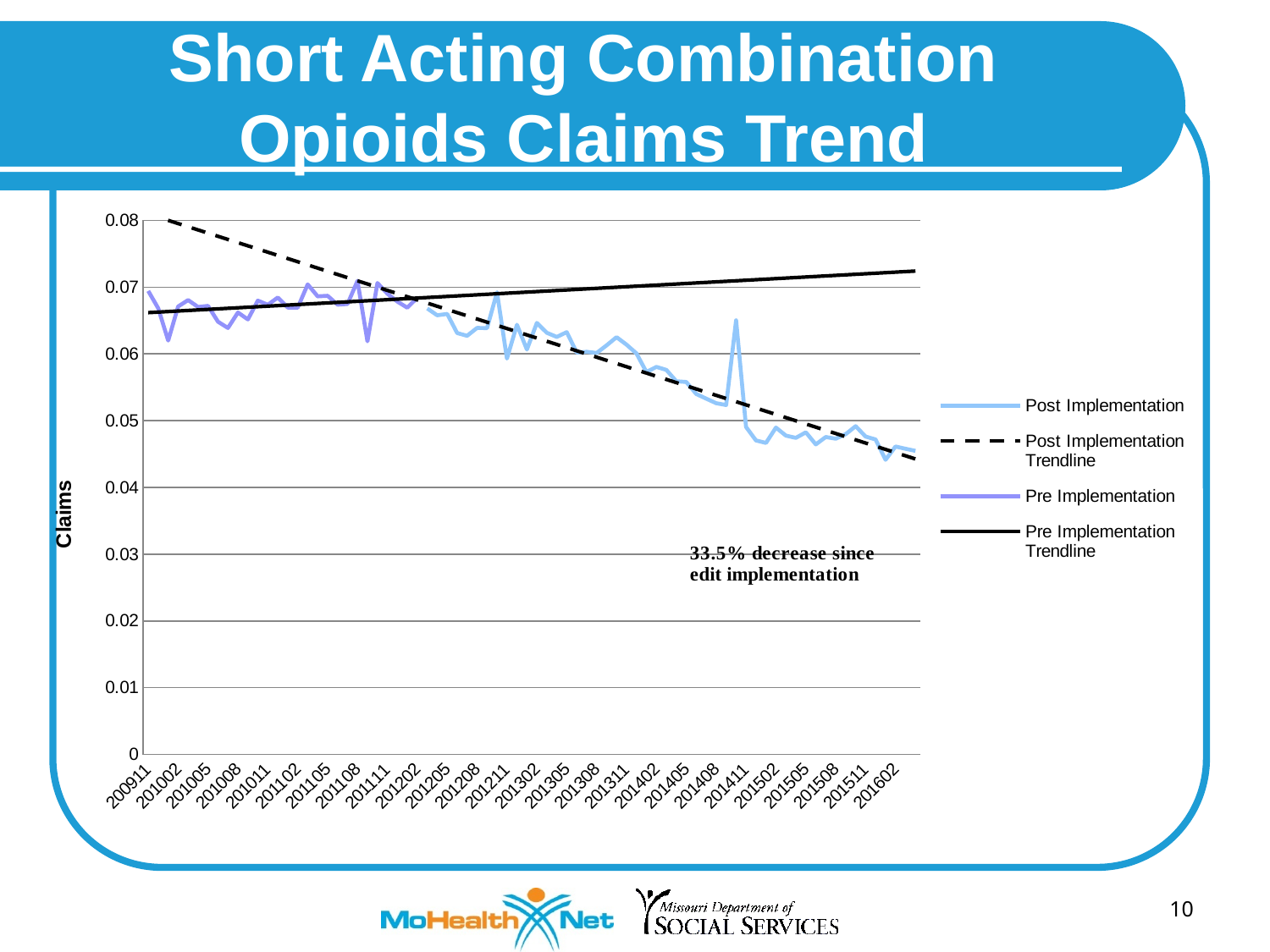
What percentage decrease since edit implementation is stated on the chart? 33.5% Does the Post Implementation Trendline rise or fall along the x axis? fall What is the label on the y axis of the chart? Claims Is the Pre Implementation value at 200911 greater or less than 0.06? greater What kind of chart is shown on the slide? line chart Does the Pre Implementation Trendline rise or fall along the x axis? rise Is the Post Implementation value at 201602 greater or less than 0.05? less Does the Post Implementation series rise or fall along the x axis? fall How many series does the legend list? 4